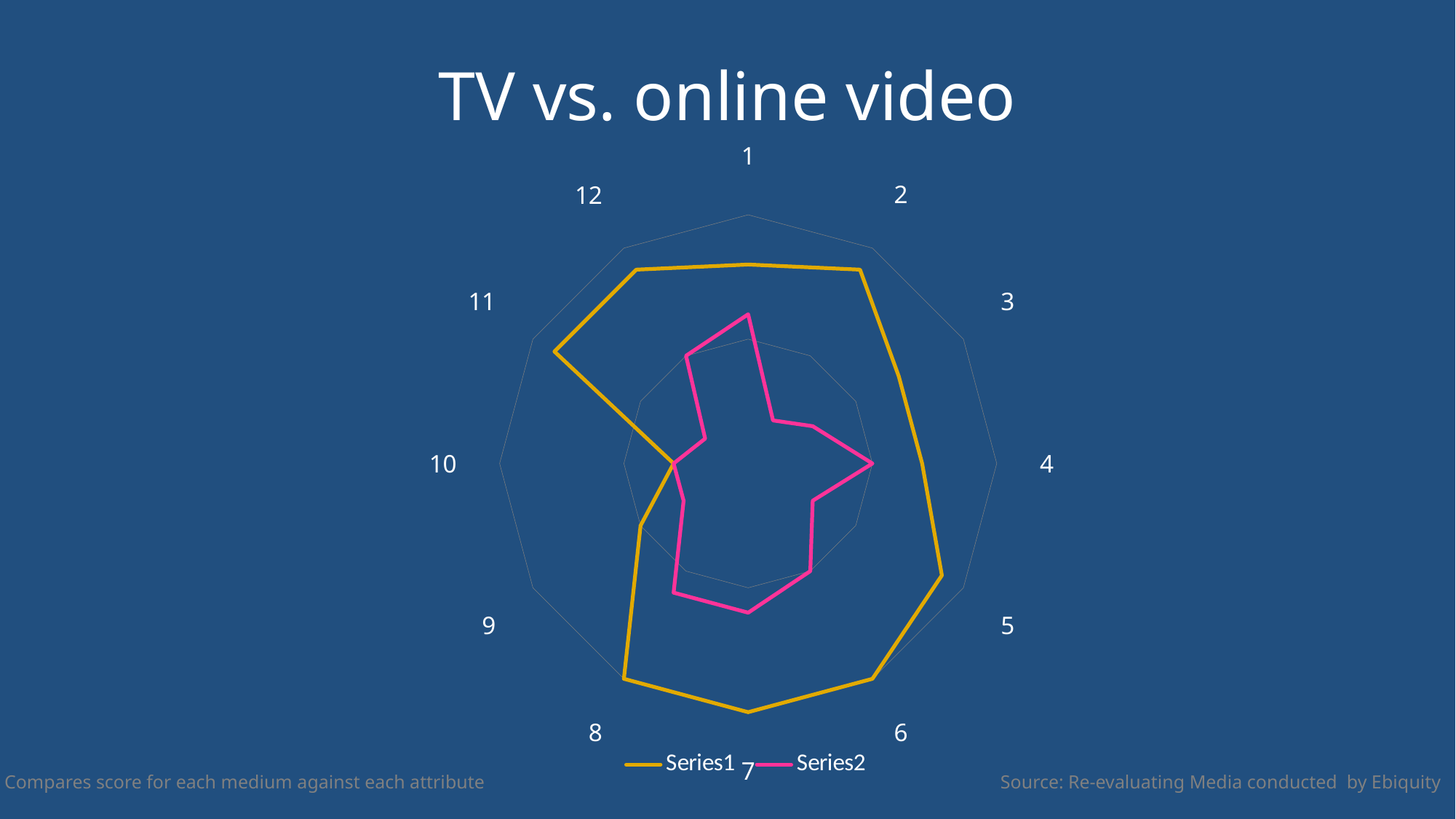
How many categories (axes) does the radar chart have? 12 At category 12, which series has the larger value, Series1 or Series2? Series1 How many series does the legend list? 2 For Series1, which category has the lowest value? 10 Which series is drawn in pink? Series2 At category 2, which series has the larger value, Series1 or Series2? Series1 At category 7, which series has the larger value, Series1 or Series2? Series1 What kind of chart is shown on the slide? Radar chart What is the title of the chart? TV vs. online video